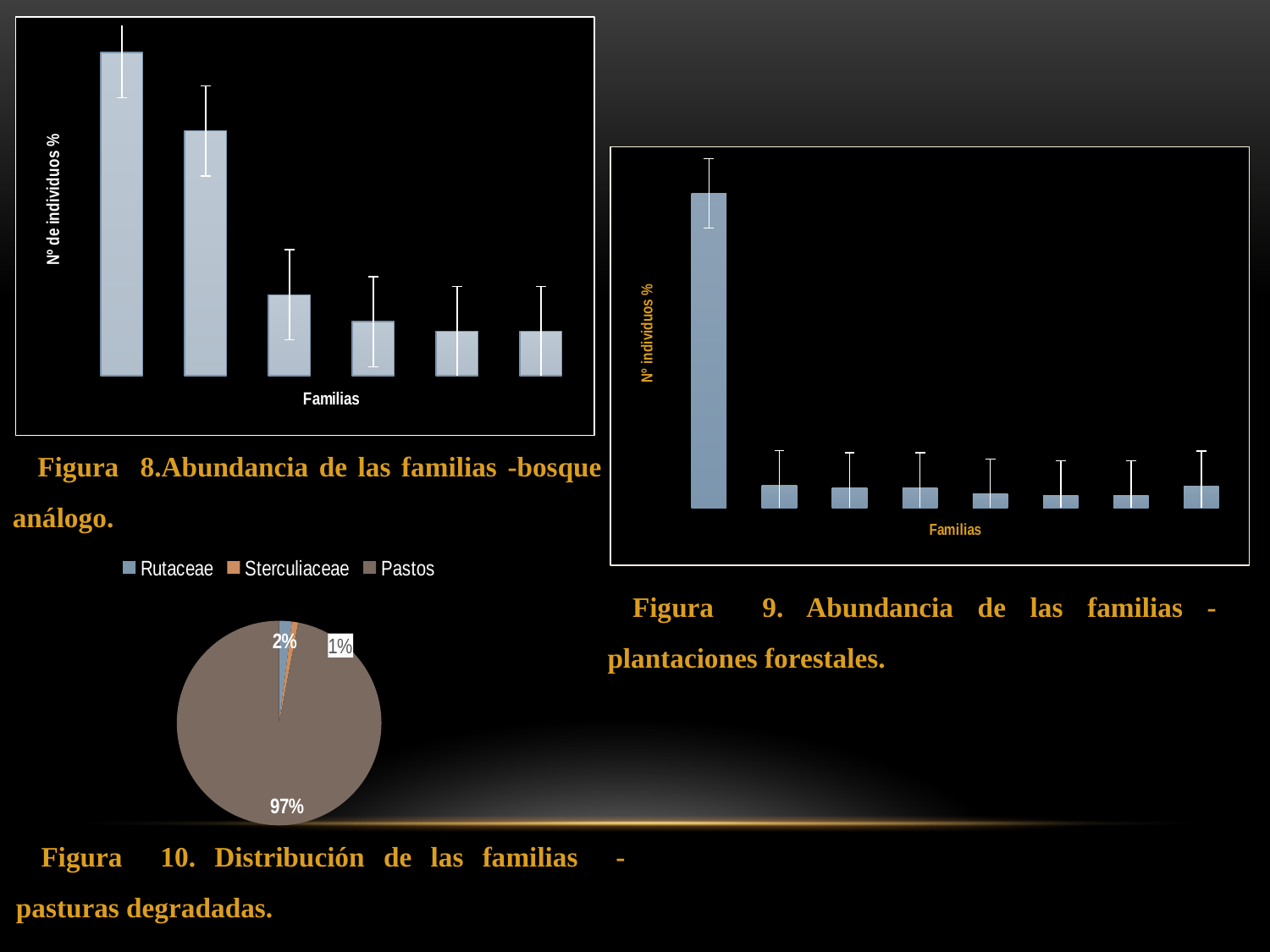
In Figura 10 (the pie chart), what share does Rutaceae have? 2% In Figura 10 (the pie chart), what share does Pastos have? 97% What is the x-axis title of Figura 9 (Abundancia de las familias - plantaciones forestales)? Familias In Figura 10 (the pie chart), which family has the smallest share? Sterculiaceae In Figura 10 (the pie chart), how many entries does the legend list? 3 In Figura 10 (the pie chart), what share does Sterculiaceae have? 1% What kind of chart is Figura 10 (Distribución de las familias - pasturas degradadas)? Pie chart In Figura 10 (the pie chart), which is larger, the share of Rutaceae or the share of Sterculiaceae? Rutaceae How many bars are plotted in Figura 9 (Abundancia de las familias - plantaciones forestales)? 8 In Figura 10 (the pie chart), what is the difference in percentage points between Pastos and Rutaceae? 95 How many bars are plotted in Figura 8 (Abundancia de las familias - bosque análogo)? 6 In Figura 10 (the pie chart), which family has the largest share? Pastos